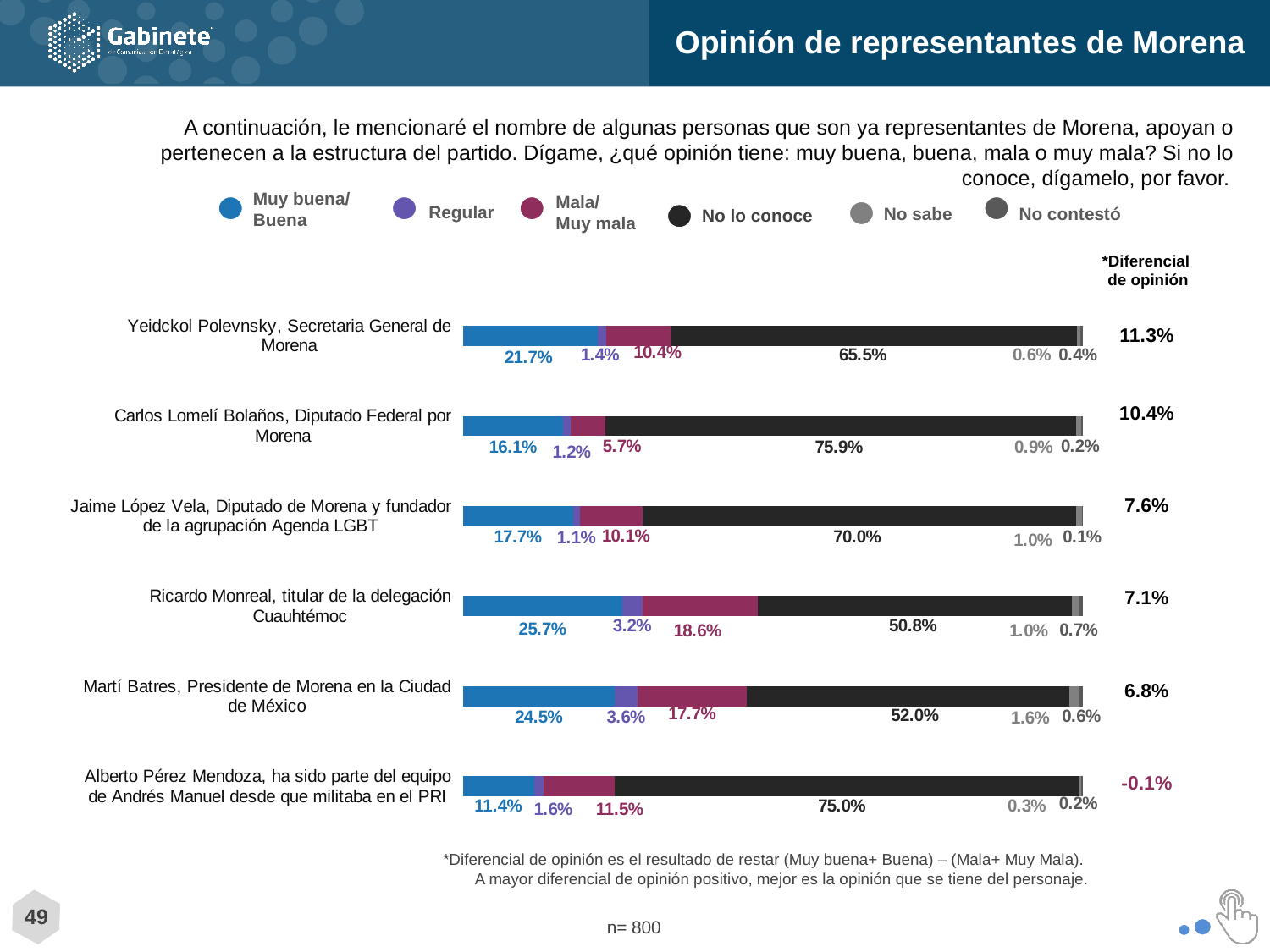
What percentage of respondents have a 'Muy buena/Buena' opinion of Ricardo Monreal, titular de la delegación Cuauhtémoc? 25.7% Which person has the highest 'Mala/Muy mala' percentage? Ricardo Monreal What is the 'Diferencial de opinión' value shown for Alberto Pérez Mendoza? -0.1% What is the difference in 'Muy buena/Buena' percentage between Yeidckol Polevnsky and Carlos Lomelí Bolaños? 5.6 percentage points What type of chart is used on this slide? Stacked bar chart Which person has the lowest 'Muy buena/Buena' percentage? Alberto Pérez Mendoza How many response categories does the legend list? 6 What is the 'Regular' value for Martí Batres, Presidente de Morena en la Ciudad de México? 3.6% What is the 'No lo conoce' value for Carlos Lomelí Bolaños, Diputado Federal por Morena? 75.9% Which person has the highest 'No lo conoce' percentage? Carlos Lomelí Bolaños How many people (categories) are shown in the chart? 6 Who has a larger 'No lo conoce' percentage, Ricardo Monreal or Martí Batres? Martí Batres